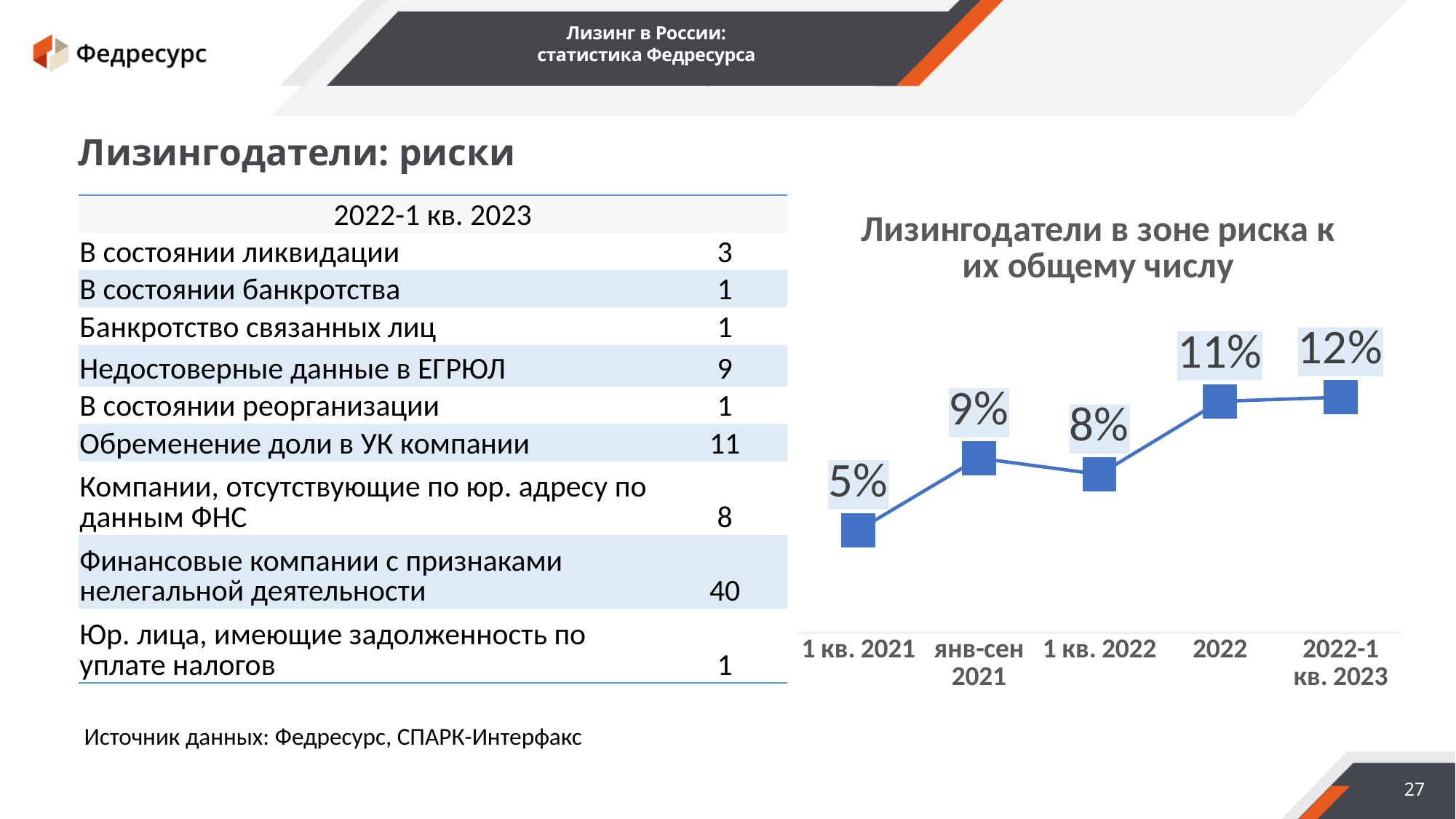
What is the difference between the values for 2022-1 кв. 2023 and 1 кв. 2021? 7% What value does the chart show for 2022? 11% Which period has the highest value on the chart? 2022-1 кв. 2023 How many data points are plotted on the chart? 5 What value does the chart show for янв-сен 2021? 9% What type of chart is shown on the slide? Line chart Which period has the lowest value on the chart? 1 кв. 2021 What value does the chart show for 1 кв. 2021? 5% What value does the chart show for 2022-1 кв. 2023? 12% What is the title of the chart? Лизингодатели в зоне риска к их общему числу What value does the chart show for 1 кв. 2022? 8% Which is larger: the value for янв-сен 2021 or the value for 1 кв. 2022? янв-сен 2021